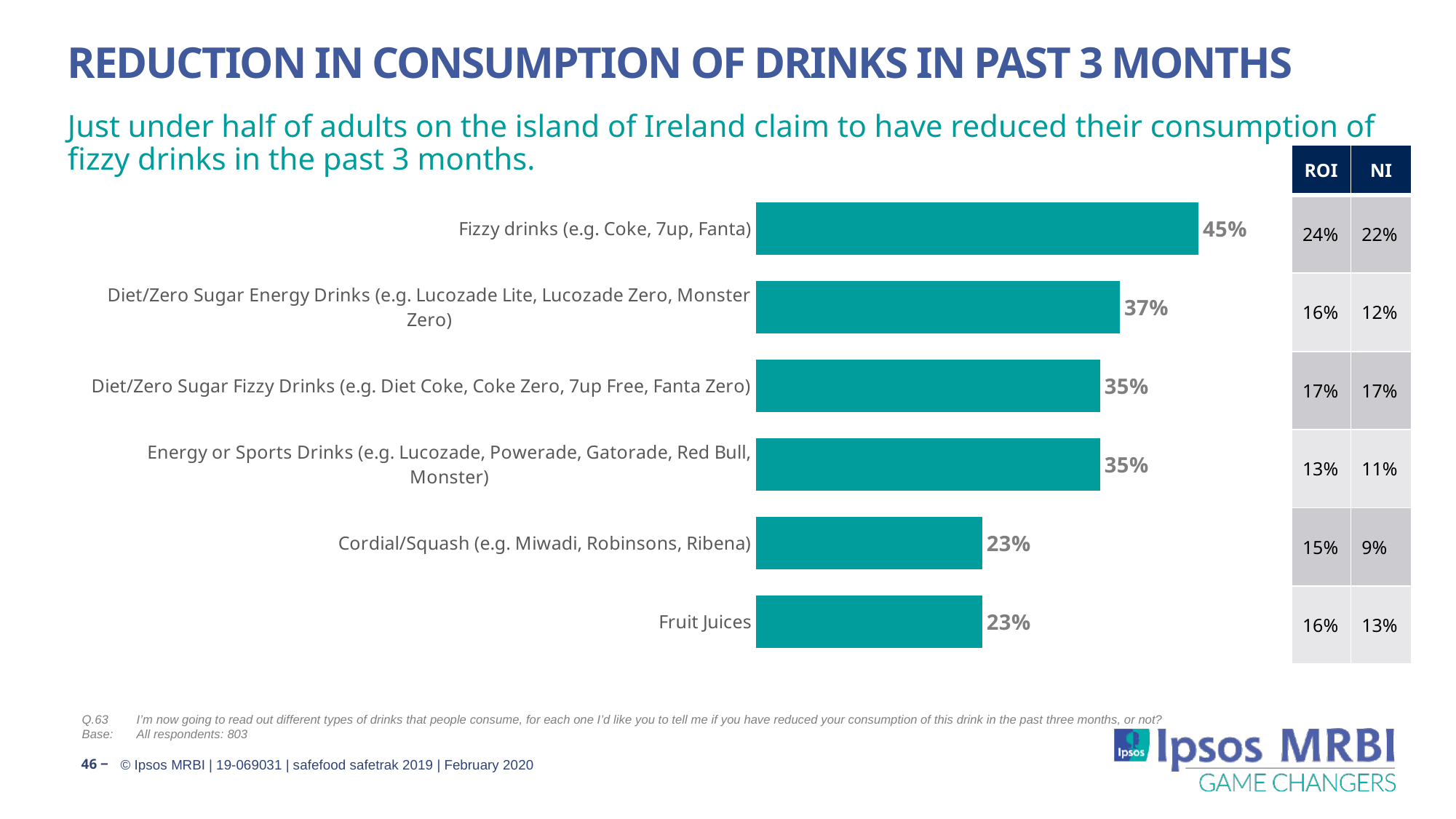
Do the values rise or fall going from the top bar to the bottom bar? Fall Which drink category has the highest reduction percentage? Fizzy drinks (e.g. Coke, 7up, Fanta) What colour are the bars in the chart? Teal How many drink categories are shown in the bar chart? 6 What is the value shown for Cordial/Squash (e.g. Miwadi, Robinsons, Ribena)? 23% Which is larger: the value for Diet/Zero Sugar Energy Drinks or the value for Energy or Sports Drinks? Diet/Zero Sugar Energy Drinks What type of chart is used on this slide? Bar chart What percentage of adults claim to have reduced their consumption of Fizzy drinks (e.g. Coke, 7up, Fanta)? 45% What is the lowest value shown on the chart? 23% What is the difference between the value for Fizzy drinks and the value for Fruit Juices? 22 percentage points What is the value shown for Diet/Zero Sugar Energy Drinks (e.g. Lucozade Lite, Lucozade Zero, Monster Zero)? 37% What is the difference between the value for Diet/Zero Sugar Energy Drinks and the value for Diet/Zero Sugar Fizzy Drinks? 2 percentage points